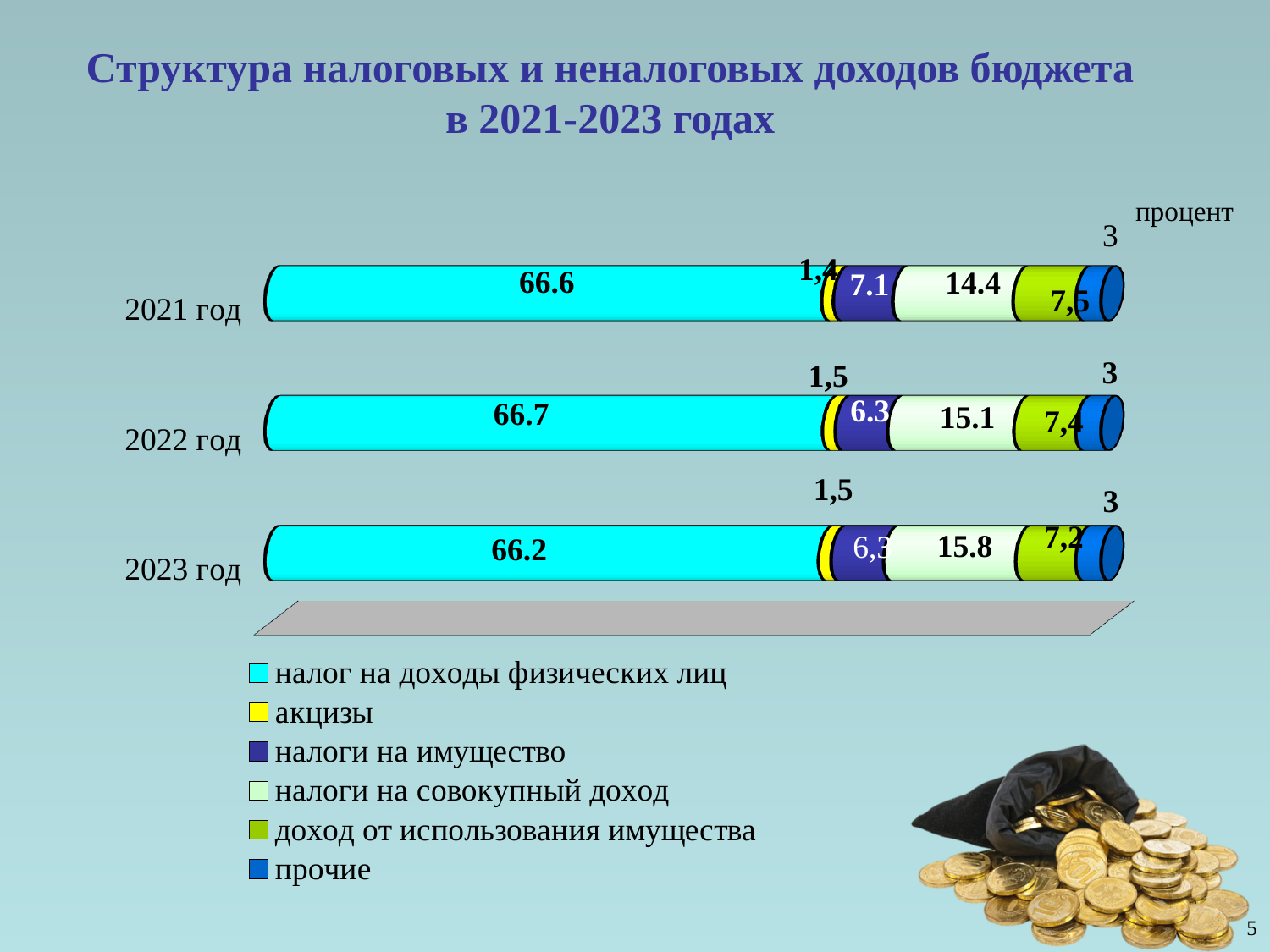
What is the value for налоги на совокупный доход in 2023 год? 15.8 How many years (bars) are shown in the chart? 3 Which year has the lowest value for налог на доходы физических лиц? 2023 год Which year has the highest value for налоги на совокупный доход? 2023 год What is the value for акцизы in 2022 год? 1,5 Which is larger: налоги на имущество in 2021 год or in 2022 год? 2021 год What is the value for налог на доходы физических лиц in 2021 год? 66.6 What kind of chart is shown on the slide? Stacked bar chart How many series does the legend list? 6 What is the value for прочие in 2023 год? 3 What is the value for налоги на имущество in 2021 год? 7.1 What is the difference between the налоги на совокупный доход values for 2023 год and 2021 год? 1.4